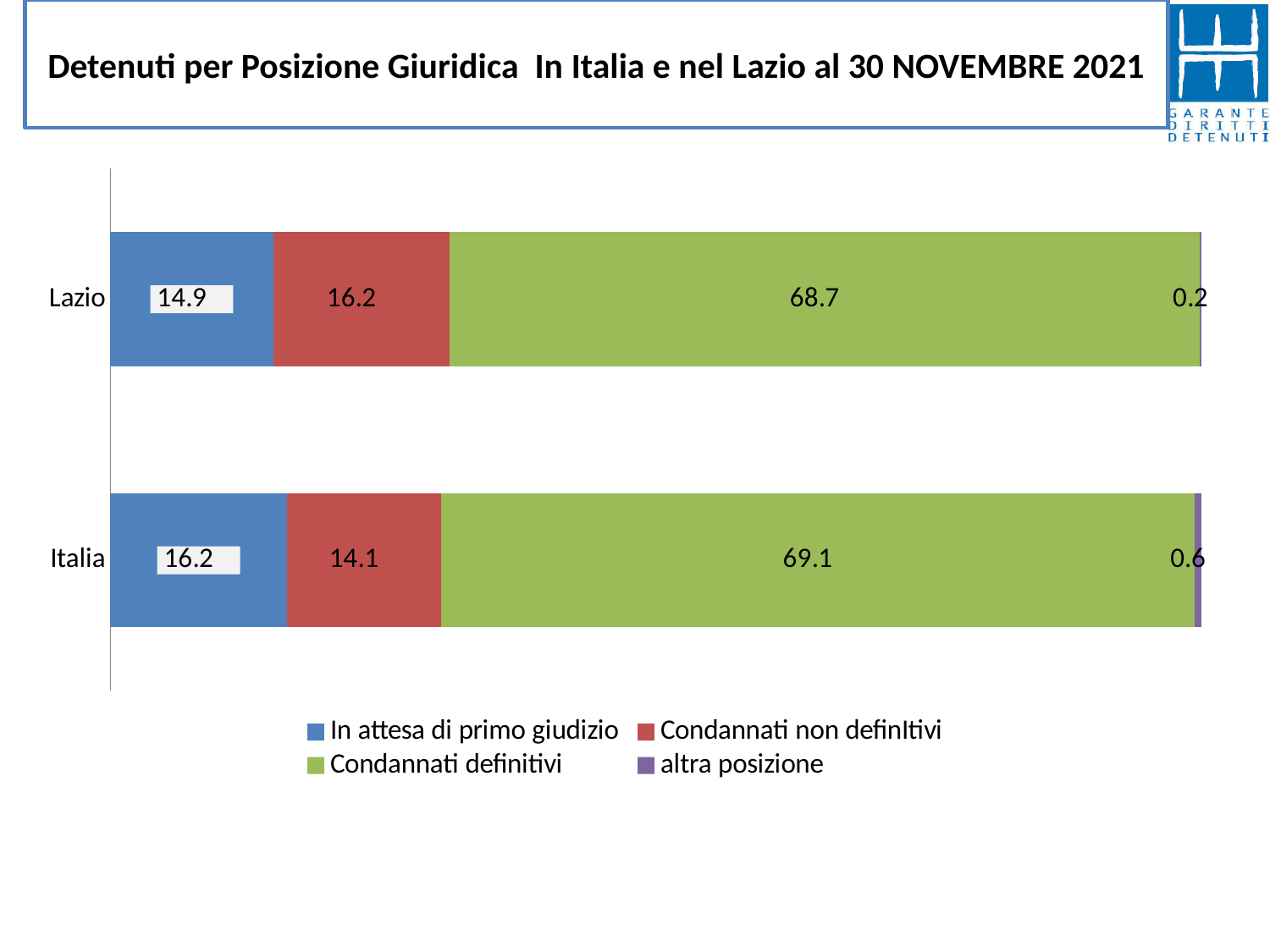
What is the difference between the 'Condannati definitivi' values for Italia and Lazio? 0.4 What is the value of 'In attesa di primo giudizio' for Lazio? 14.9 Which series has the largest value in the Lazio bar? Condannati definitivi How many categories (bars) are shown in the chart? 2 Which is larger: 'In attesa di primo giudizio' for Italia or for Lazio? Italia What is the value of 'altra posizione' for Italia? 0.6 Which series has the smallest value in the Italia bar? altra posizione What is the value of 'Condannati non definitivi' for Lazio? 16.2 What is the title of the chart on the slide? Detenuti per Posizione Giuridica In Italia e nel Lazio al 30 NOVEMBRE 2021 How many series does the legend list? 4 What kind of chart is shown on the slide? Stacked bar chart What is the value of 'Condannati definitivi' for Italia? 69.1